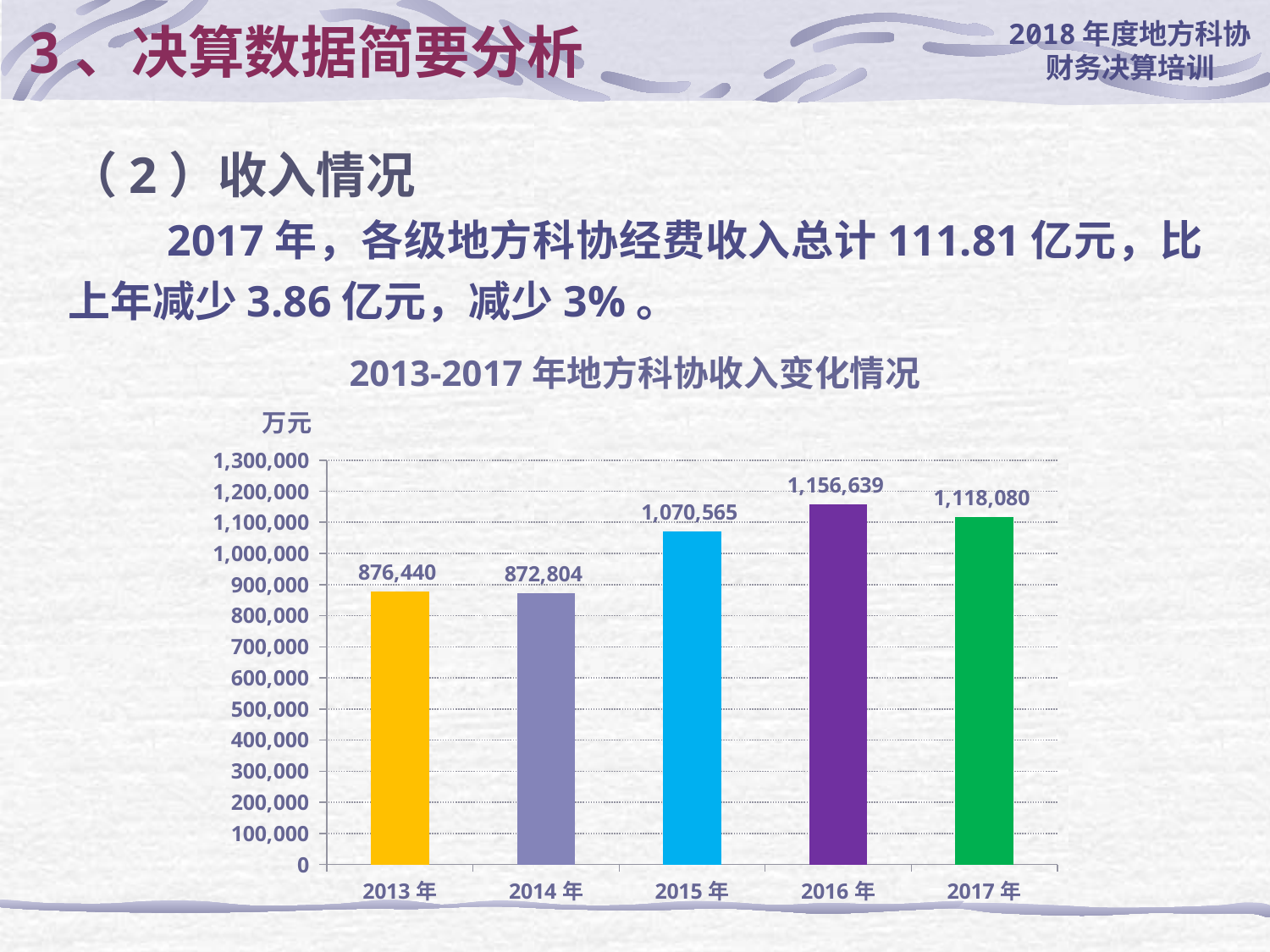
Which year has the lowest value in the chart? 2014年 What is the value for 2013年 in the chart? 876,440 Is the value for 2015年 greater or less than 1,000,000? greater Which year has the highest value in the chart? 2016年 Which is larger, the value for 2015年 or the value for 2017年? 2017年 What is the difference between the values for 2015年 and 2014年? 197,761 What kind of chart is shown on the slide? bar chart How many years are shown in the chart? 5 What is the title of the chart? 2013-2017年地方科协收入变化情况 What is the value for 2016年 in the chart? 1,156,639 What is the difference between the values for 2016年 and 2017年? 38,559 What is the value for 2017年 in the chart? 1,118,080